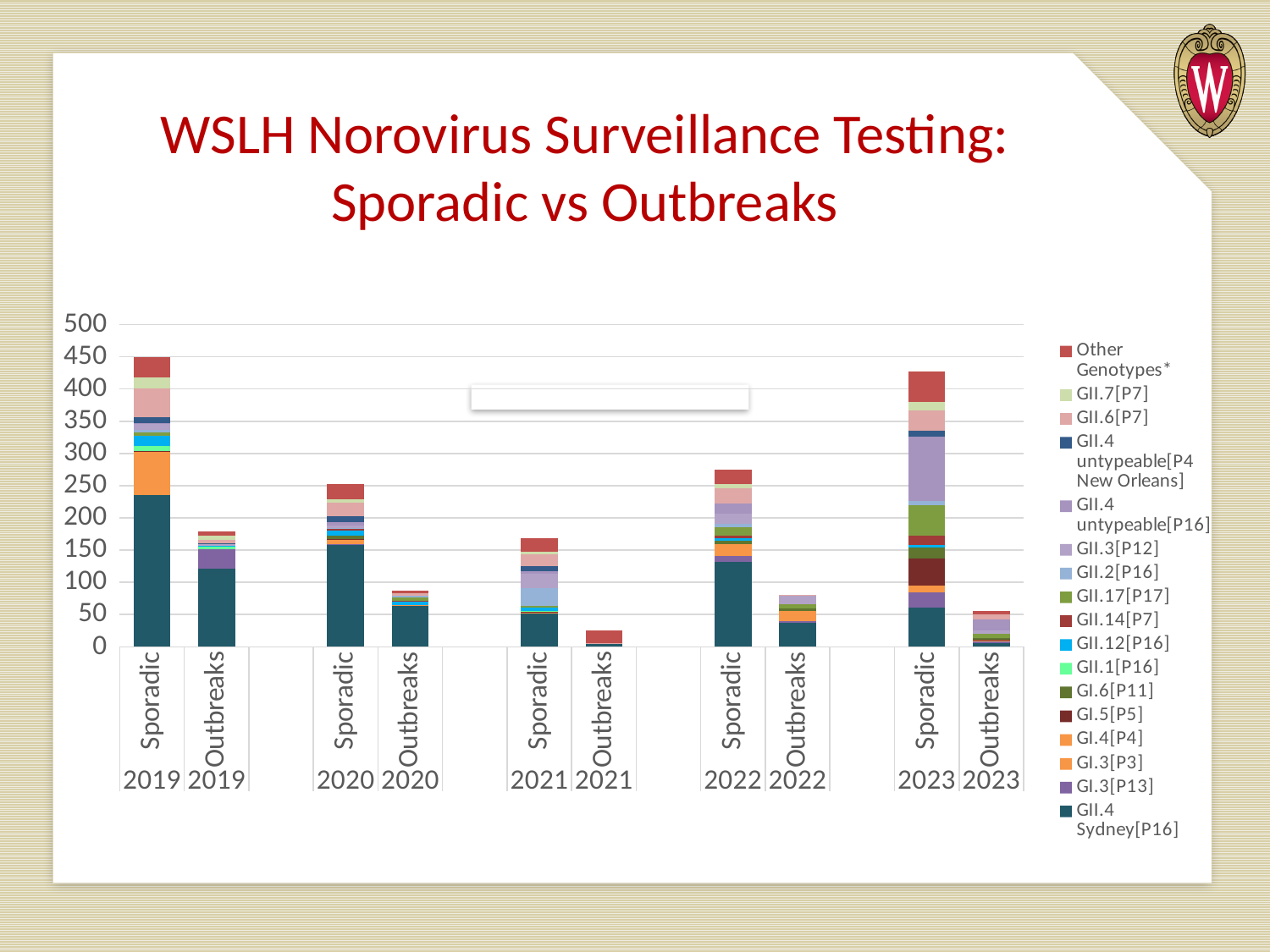
Is the total for Outbreaks 2021 greater or less than 50? less Which series is shown at the bottom of each stacked bar, in dark teal? GII.4 Sydney[P16] Is the total for Sporadic 2023 greater or less than 400? greater What is the title of the slide? WSLH Norovirus Surveillance Testing: Sporadic vs Outbreaks How many series does the legend list? 17 How many bars are plotted in the chart? 10 Is the total for Sporadic 2022 greater or less than 250? greater What kind of chart is shown on the slide? Stacked bar chart Which is larger, the total for Sporadic 2020 or the total for Outbreaks 2020? Sporadic 2020 Which bar has the lowest total? Outbreaks 2021